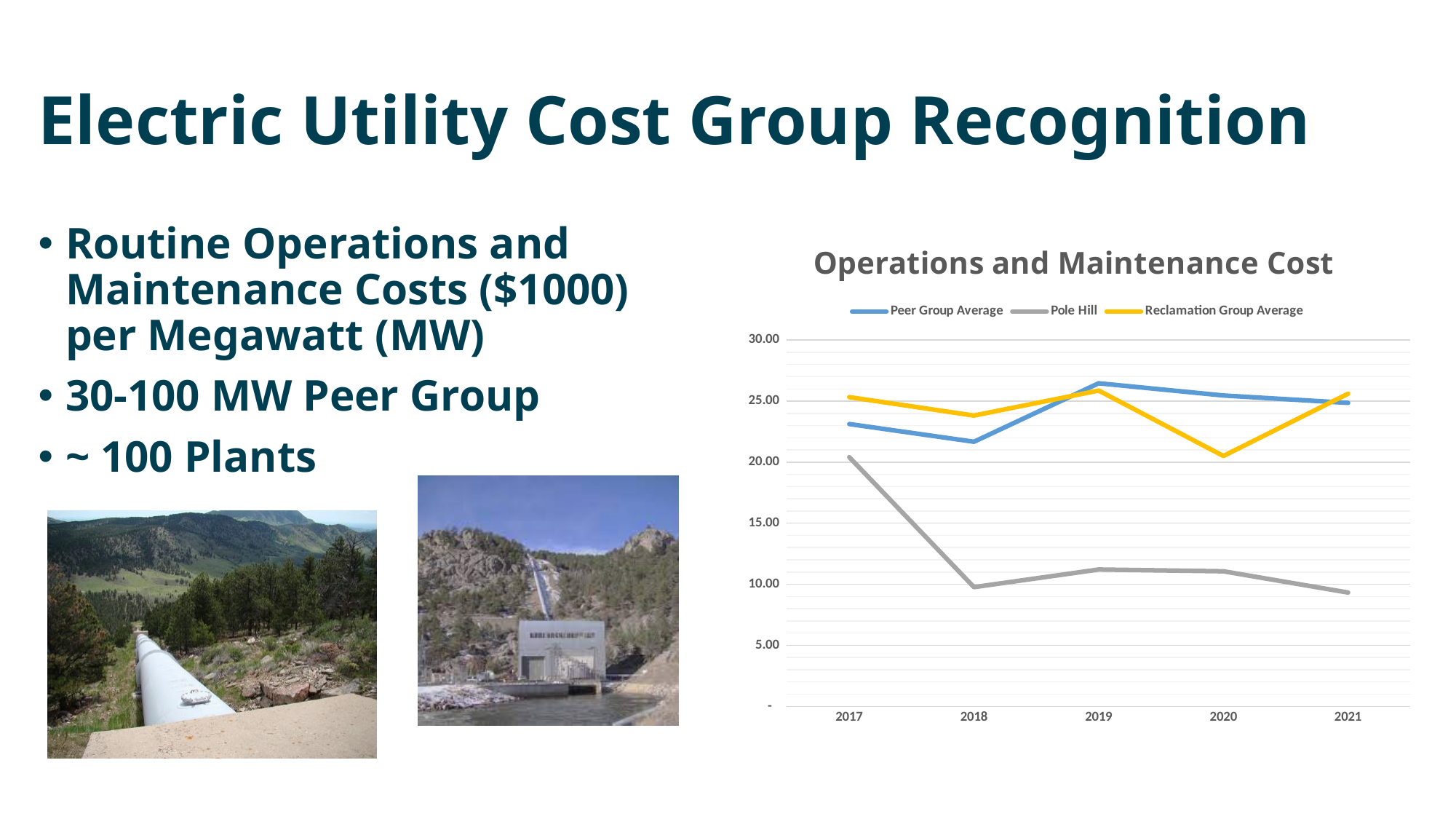
Does the Pole Hill line rise or fall from 2017 to 2018? fall Is the value for Pole Hill in 2017 greater or less than 15.00? greater What kind of chart is shown on the slide? line chart How many years are plotted along the x axis of the chart? 5 Is the value for Pole Hill in 2018 greater or less than 15.00? less Is the value for Reclamation Group Average in 2020 greater or less than 25.00? less How many series does the legend of the Operations and Maintenance Cost chart list? 3 Which series has the lowest value in 2021? Pole Hill What is the title of the chart? Operations and Maintenance Cost In which year is the Pole Hill value highest? 2017 In 2018, which is larger: Peer Group Average or Pole Hill? Peer Group Average